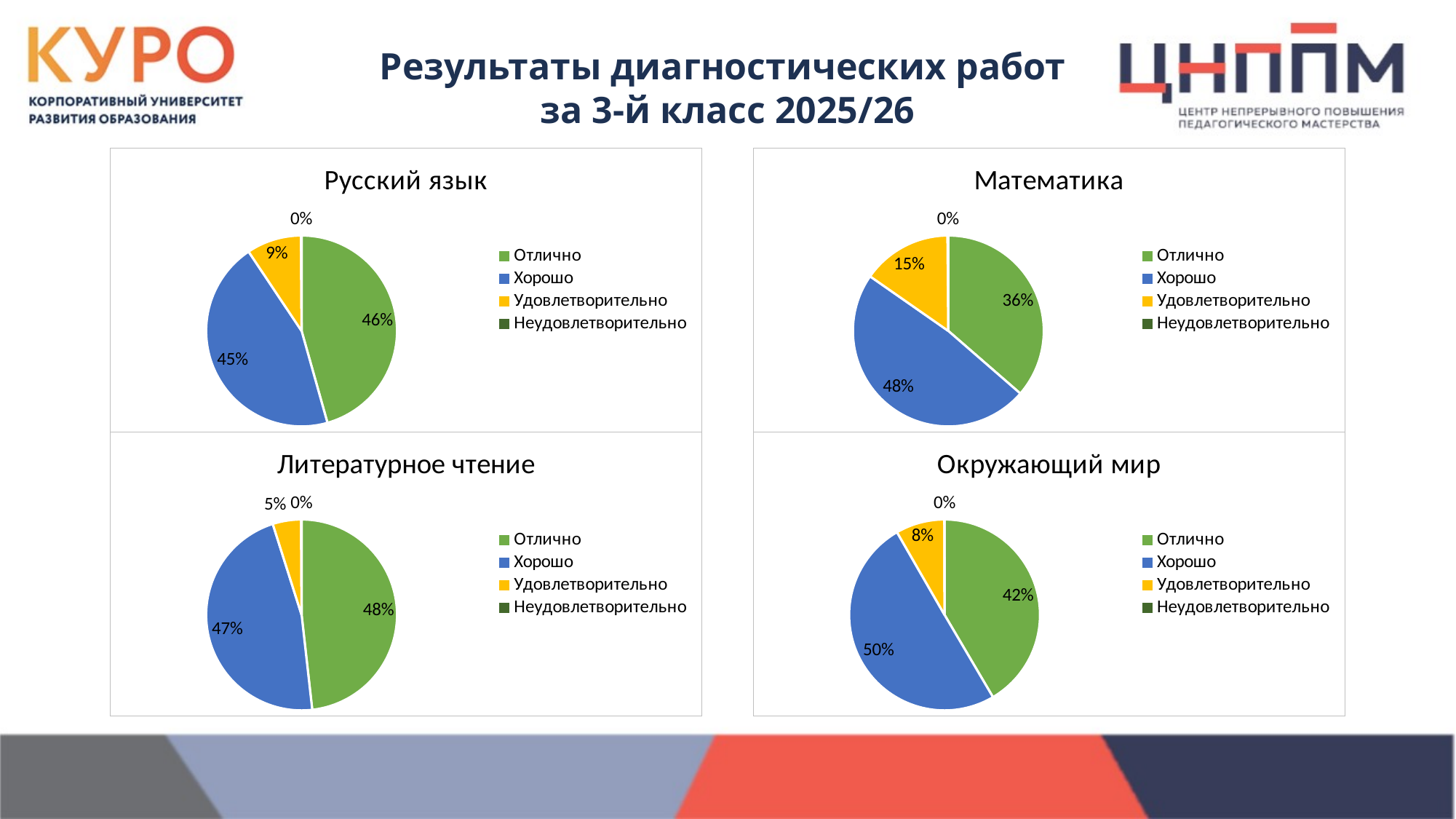
In the "Математика" pie chart, which category has the largest share? Хорошо In the "Русский язык" pie chart, what share is labelled for "Отлично"? 46% What kind of chart is used for "Литературное чтение"? Pie chart In the "Окружающий мир" pie chart, what share is labelled for "Отлично"? 42% In the "Литературное чтение" pie chart, what share is labelled for "Хорошо"? 47% In the "Окружающий мир" pie chart, which category has the largest share? Хорошо In the "Литературное чтение" pie chart, which is larger: the share for "Отлично" or the share for "Хорошо"? Отлично In the "Математика" pie chart, what share is labelled for "Удовлетворительно"? 15% In the "Окружающий мир" pie chart, what is the difference between the shares for "Хорошо" and "Удовлетворительно"? 42% In the "Русский язык" chart, which colour represents "Удовлетворительно"? Yellow In the "Математика" pie chart, what is the difference between the shares for "Хорошо" and "Отлично"? 12% How many entries does the legend of the "Русский язык" chart list? 4